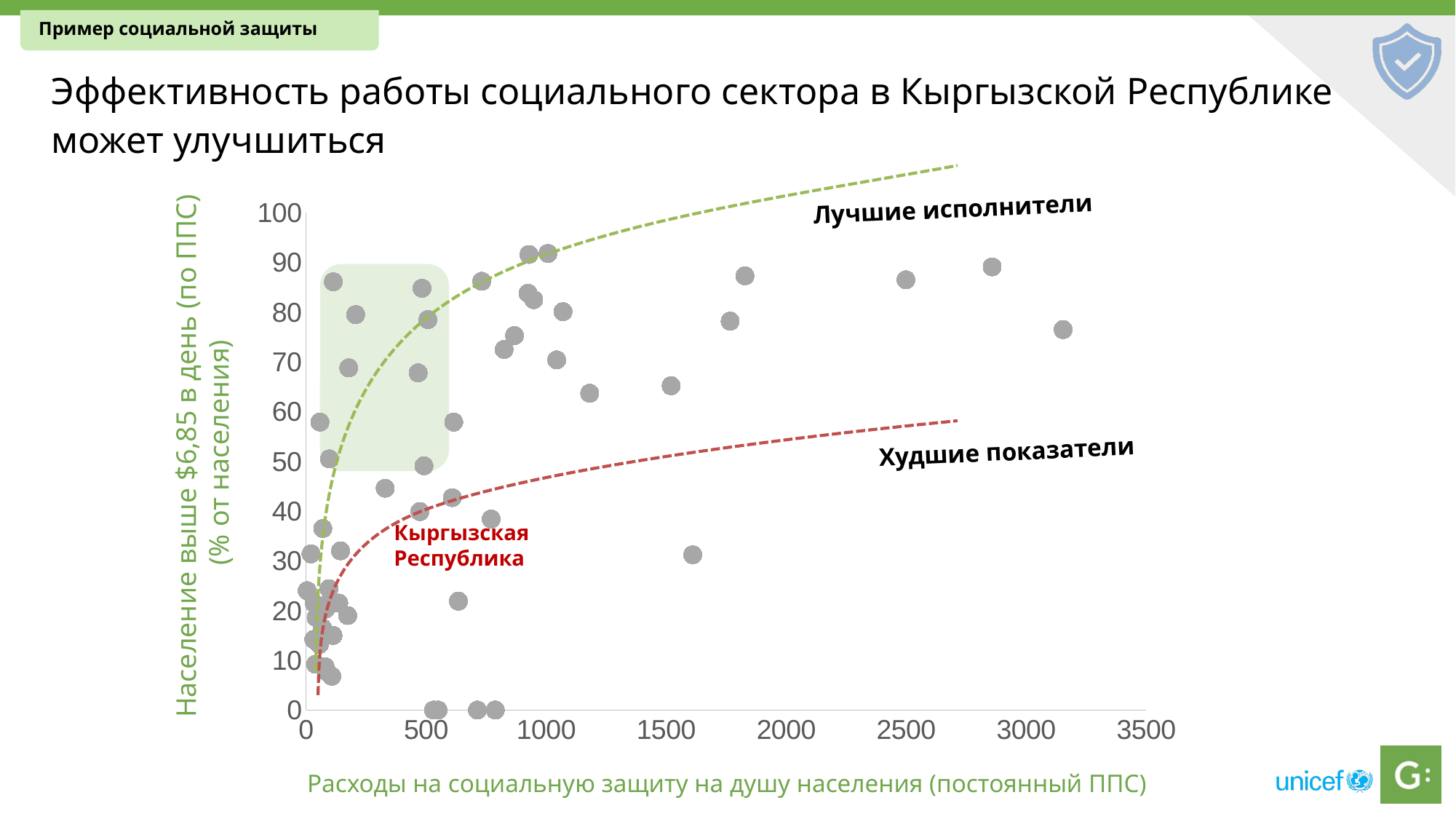
What kind of chart is shown on the slide? scatter chart Is the value for Кыргызская Республика greater or less than 50? less Do the plotted values generally rise or fall as spending on the x axis increases? rise What label is given to the lower red dashed line? Худшие показатели What label is given to the upper green dashed line? Лучшие исполнители